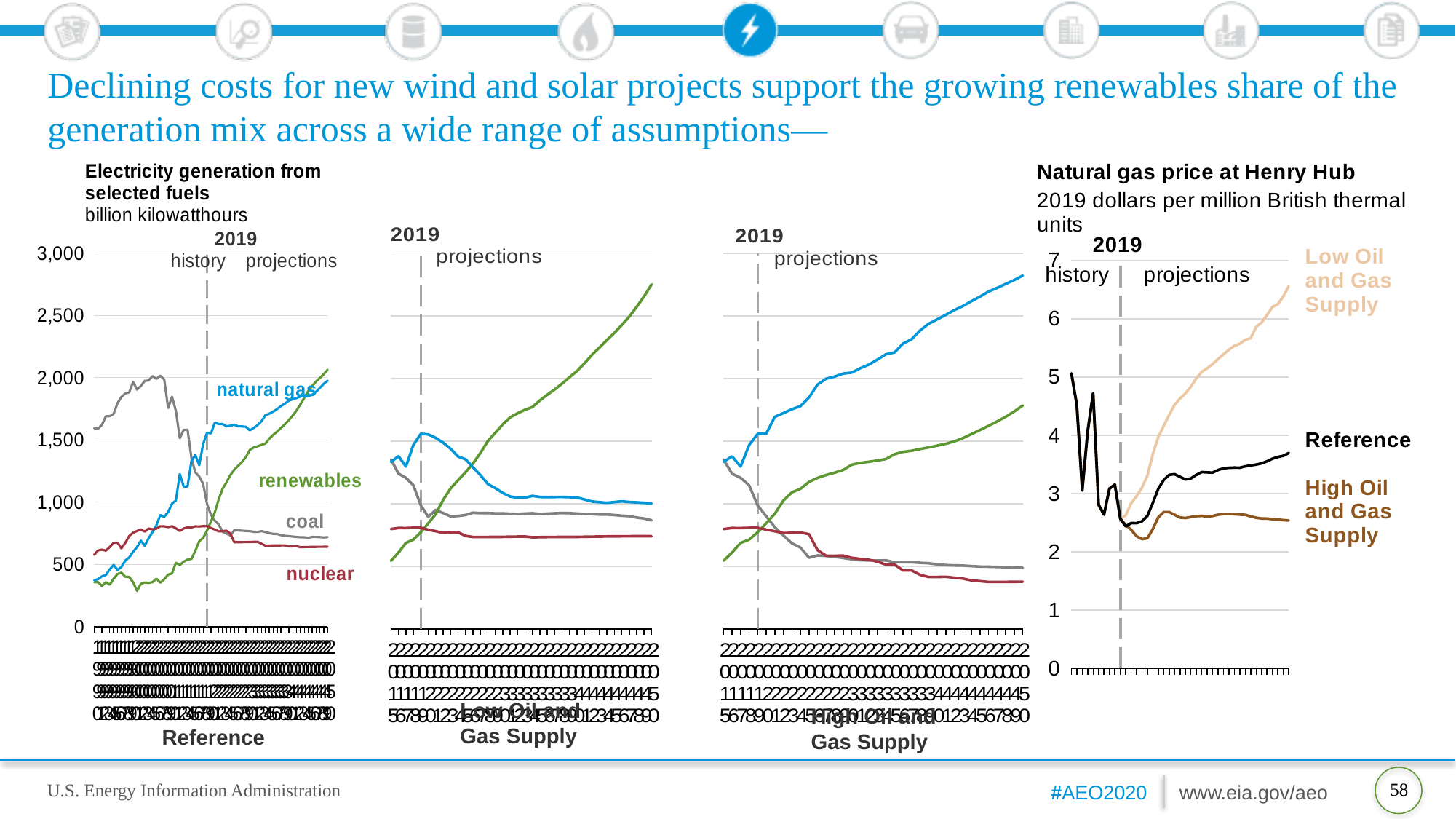
In the Natural gas price at Henry Hub chart, which is higher at the end of the projection period, Low Oil and Gas Supply or Reference? Low Oil and Gas Supply In the Reference chart, is the nuclear value at the end of the projection period greater or less than 1,000? less In the Reference chart, does the coal line rise or fall over the projection period? fall In the High Oil and Gas Supply electricity generation chart, which fuel has the highest generation at the end of the projection period? natural gas In the Reference electricity generation chart, how many fuel series are labeled? 4 What kind of chart is the Reference chart on the left? line chart What units are used in the Natural gas price at Henry Hub chart? 2019 dollars per million British thermal units In the Reference chart, is the natural gas value at the end of the projection period greater or less than 1,500? greater In the Reference chart, does the renewables line rise or fall over the projection period? rise In the Natural gas price at Henry Hub chart, is the High Oil and Gas Supply value at the end of the projection period greater or less than 3? less In the Natural gas price at Henry Hub chart, how many series are labeled? 3